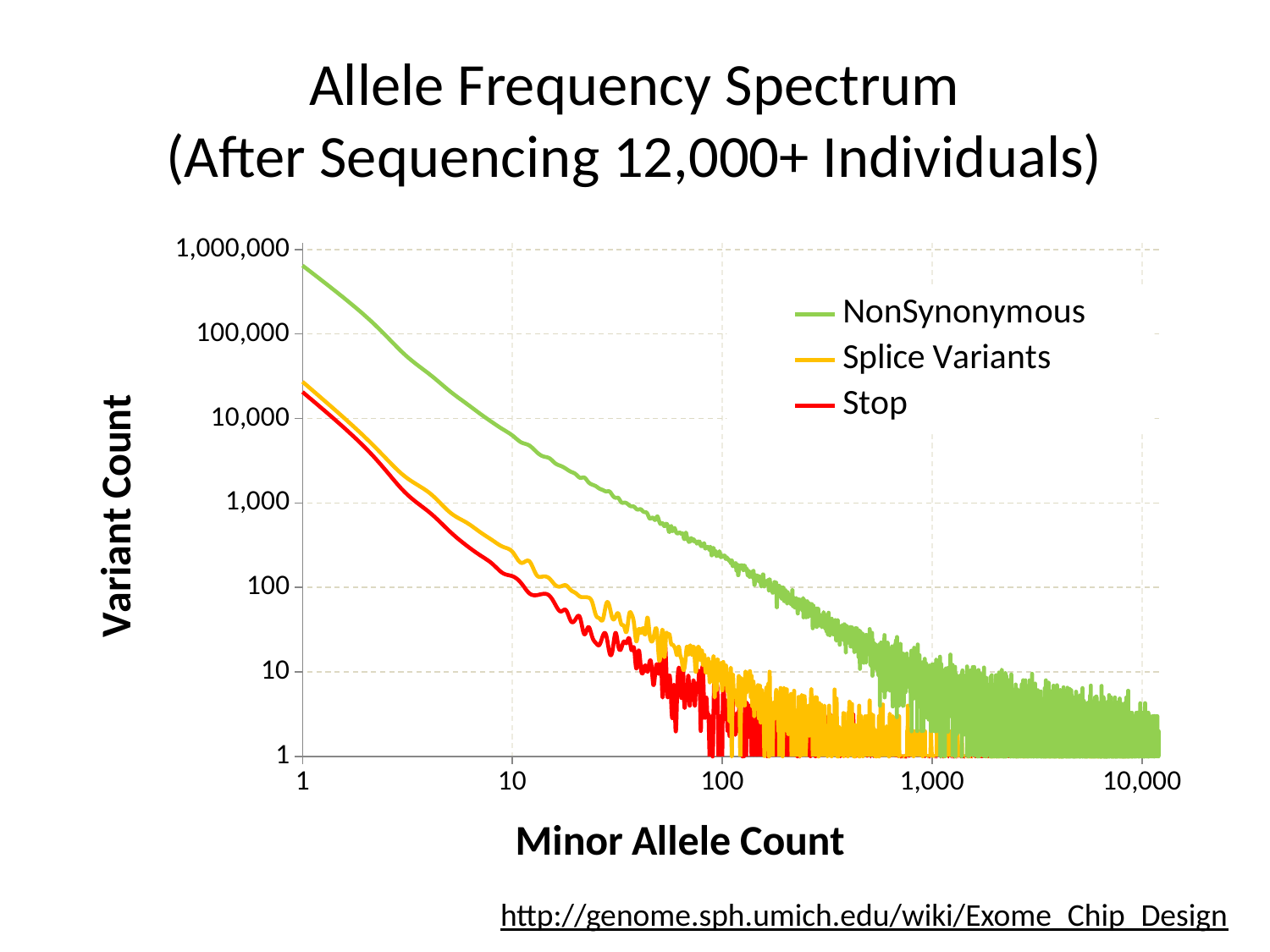
What kind of chart is shown on the slide? line chart What is the label of the x axis? Minor Allele Count At a minor allele count of 1, which is larger: the variant count for NonSynonymous or for Stop? NonSynonymous Is the variant count for NonSynonymous at a minor allele count of 10 greater or less than 1,000? greater Does the variant count for NonSynonymous rise or fall as the minor allele count increases? fall What colour is the Stop series line? red Which series has the lowest variant count at a minor allele count of 1? Stop Which series has the highest variant count at a minor allele count of 1? NonSynonymous Is the variant count for Stop at a minor allele count of 1 greater or less than 100,000? less Is the variant count for Splice Variants at a minor allele count of 1 greater or less than 10,000? greater How many series does the legend list? 3